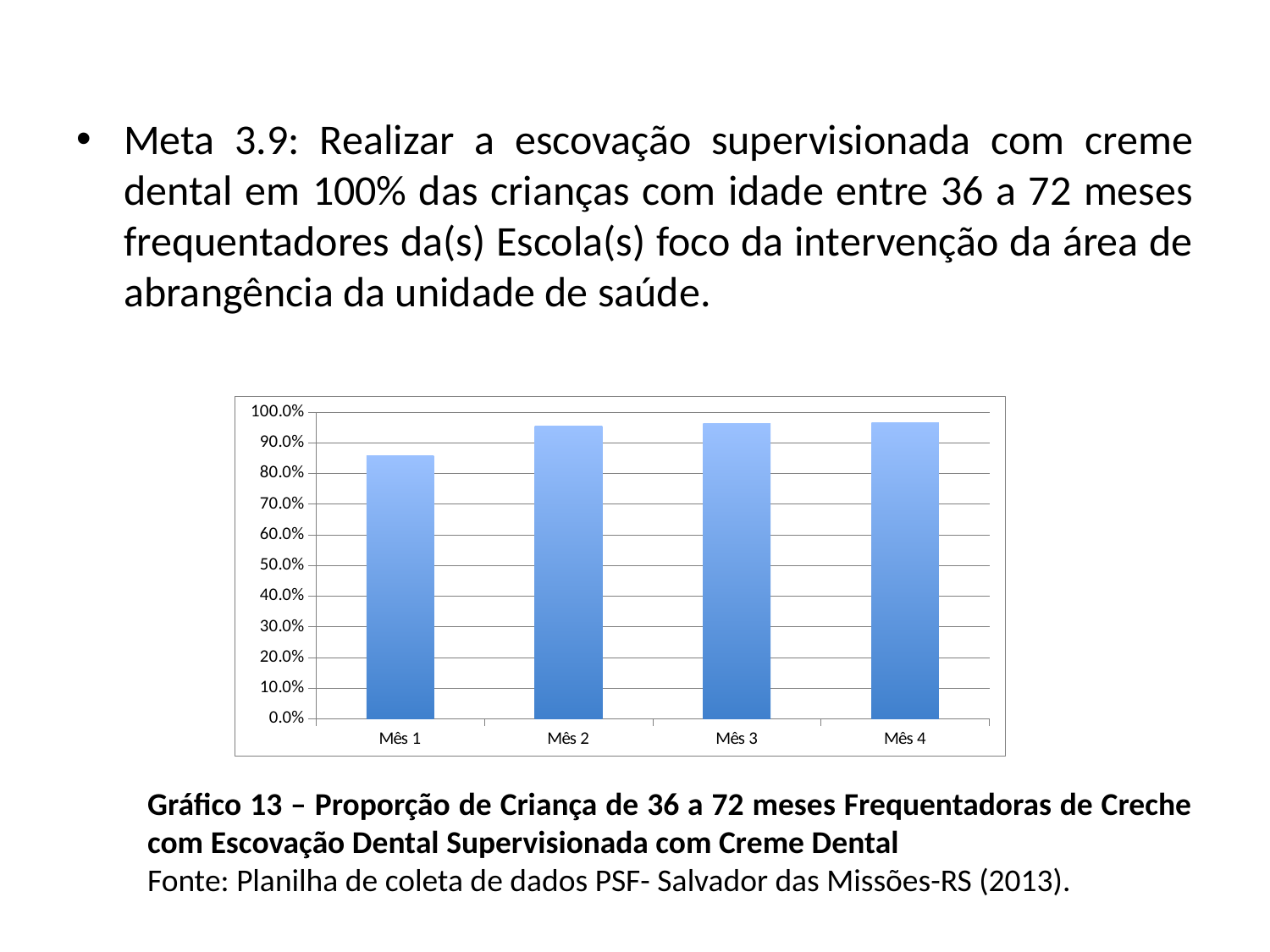
Is the value for Mês 1 greater or less than 90.0%? less What is the highest tick value shown on the y axis of the chart? 100.0% Which is larger, the value for Mês 1 or the value for Mês 2? Mês 2 Which month has the lowest value in the chart? Mês 1 What kind of chart is shown on the slide? bar chart Is the value for Mês 3 greater or less than 90.0%? greater What is the number of the graph given in the caption below the chart? Gráfico 13 How many categories (months) are shown on the x axis of the chart? 4 Is the value for Mês 2 greater or less than 90.0%? greater Do the values generally rise or fall from Mês 1 to Mês 4? rise